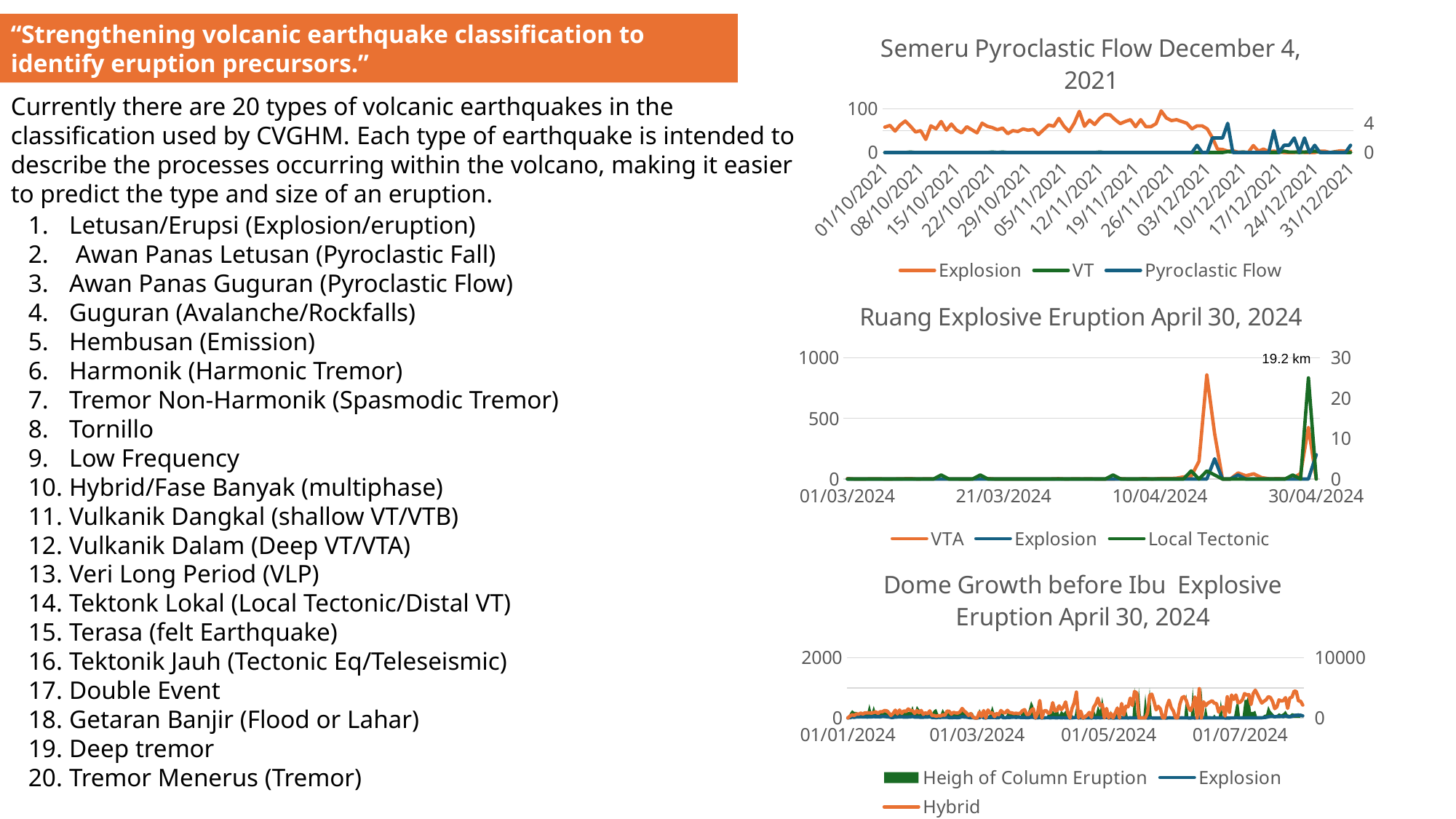
How many series does the legend of the 'Dome Growth before Ibu Explosive Eruption April 30, 2024' chart list? 3 How many date labels are shown on the x axis of the 'Ruang Explosive Eruption April 30, 2024' chart? 4 What kind of chart is the 'Ruang Explosive Eruption April 30, 2024' chart? line chart How many series does the legend of the 'Semeru Pyroclastic Flow December 4, 2021' chart list? 3 In the 'Dome Growth before Ibu Explosive Eruption April 30, 2024' chart, is the highest value of the Hybrid series greater or less than 2000? less What kind of chart is the 'Semeru Pyroclastic Flow December 4, 2021' chart? line chart In the 'Dome Growth before Ibu Explosive Eruption April 30, 2024' chart, what is the maximum value shown on the right-hand axis? 10000 How many series does the legend of the 'Ruang Explosive Eruption April 30, 2024' chart list? 3 In the 'Ruang Explosive Eruption April 30, 2024' chart, what data label is printed near the peak of the Local Tectonic series? 19.2 km In the 'Ruang Explosive Eruption April 30, 2024' chart, is the peak value of the VTA series greater or less than 500? greater In the 'Semeru Pyroclastic Flow December 4, 2021' chart, which series are listed in the legend? Explosion, VT, Pyroclastic Flow